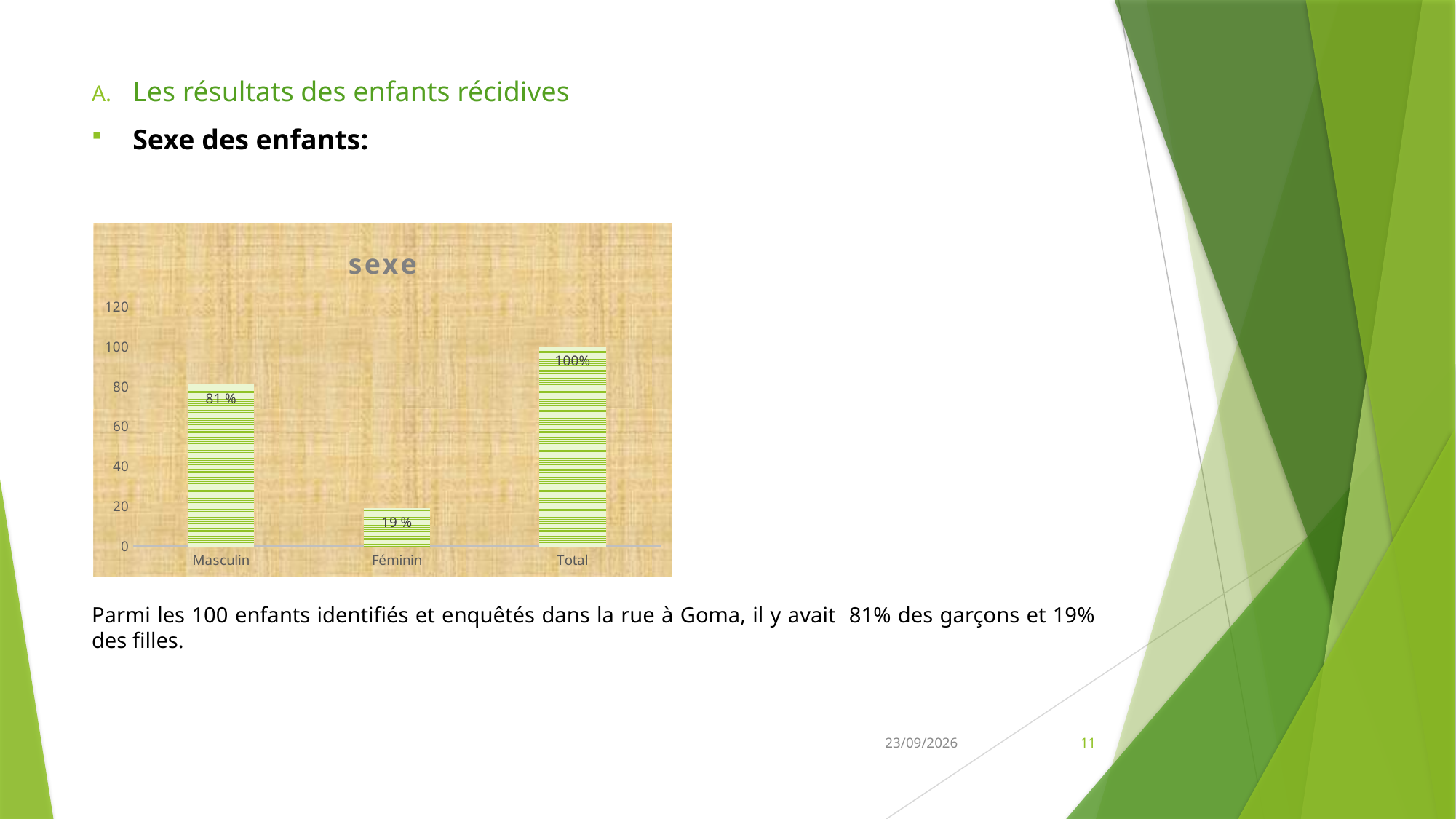
How many categories are shown on the x axis of the chart? 3 Is the value for Masculin greater or less than 60? greater Which category has the lowest value in the chart? Féminin Is the value for Féminin greater or less than 40? less What kind of chart is shown on the slide? Bar chart What is the difference between the Masculin and Féminin values? 62 % What is the value shown for Masculin in the chart? 81 % Which is larger, the value for Masculin or the value for Féminin? Masculin What is the title of the chart? sexe What is the value shown for Total in the chart? 100% What is the value shown for Féminin in the chart? 19 % Which category has the highest value in the chart? Total